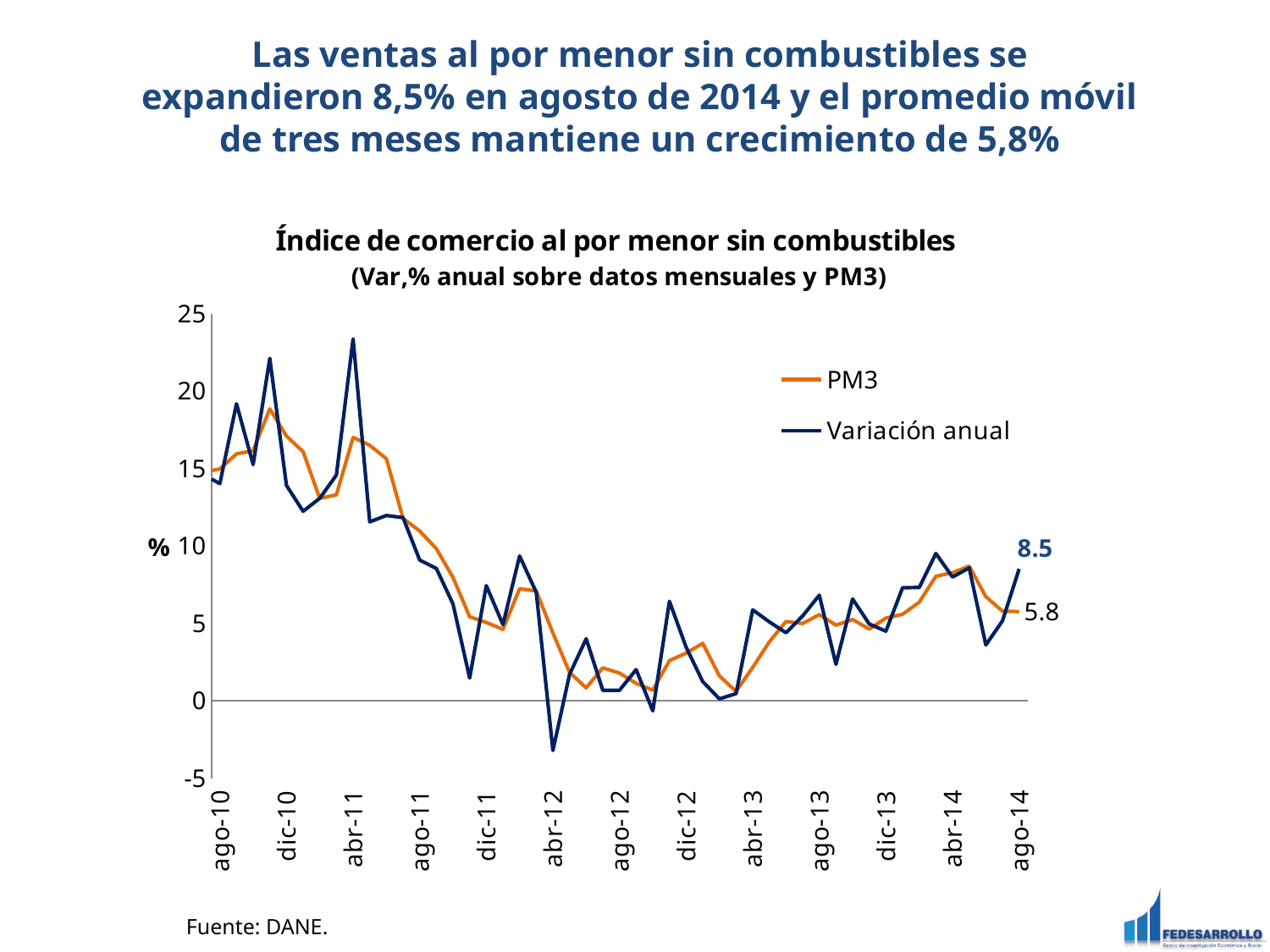
At ago-14, which series has the larger value, PM3 or Variación anual? Variación anual Is the value of Variación anual at abr-12 greater or less than 0? less What is the value of Variación anual at ago-14? 8.5 Is the value of Variación anual at abr-11 greater or less than 20? greater Overall, does the PM3 line rise or fall from ago-10 to ago-14? fall Which series reaches the highest value anywhere on the chart? Variación anual How many series does the legend list? 2 What is the title of the chart? Índice de comercio al por menor sin combustibles What is the value of PM3 at ago-14? 5.8 Is the value of Variación anual at ago-11 greater or less than 10? less What is the difference between Variación anual and PM3 at ago-14? 2.7 What kind of chart is shown on the slide? line chart